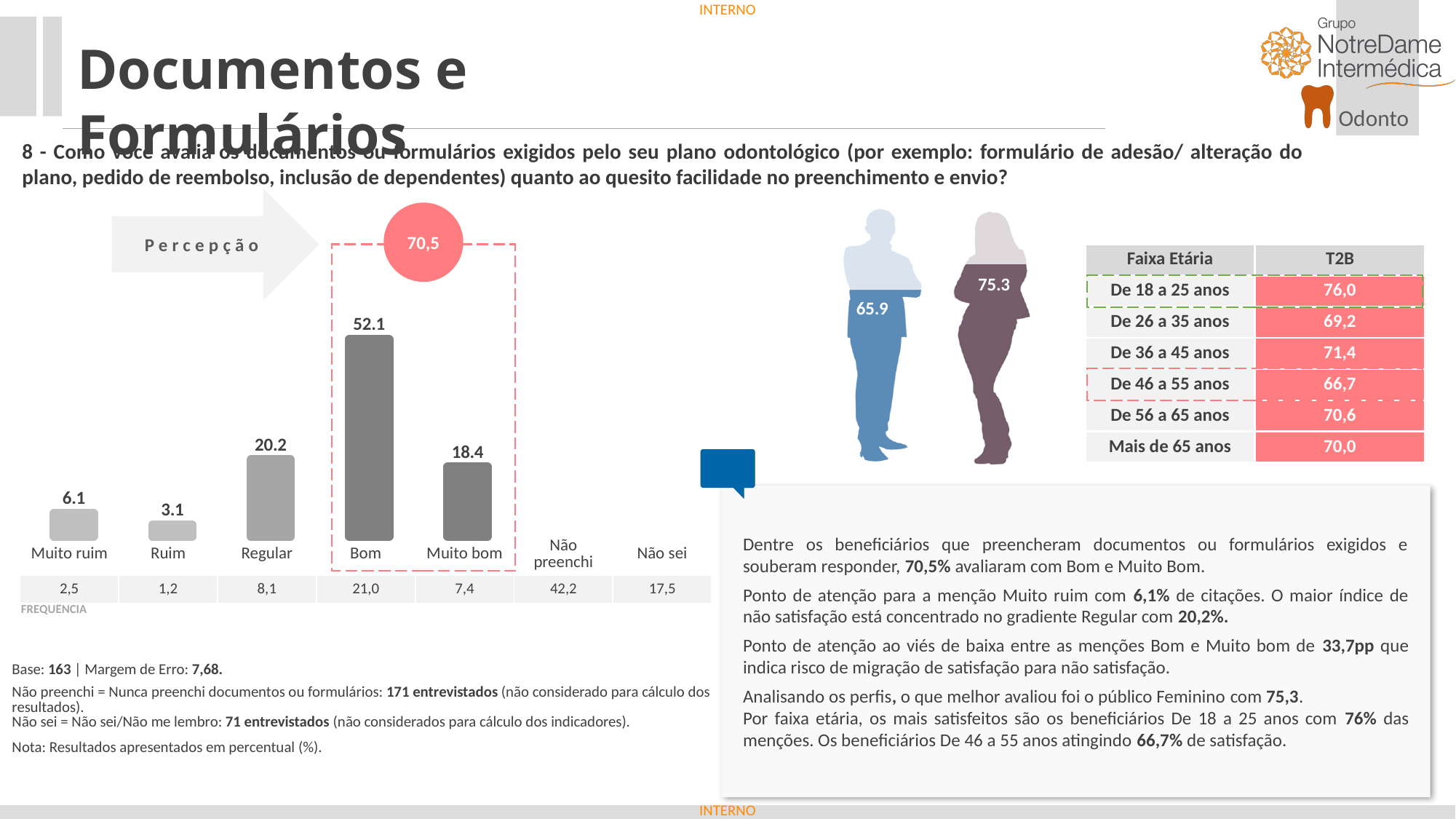
How many bars are plotted in the chart? 5 What type of chart is used to show the evaluation of documents and forms? Bar chart What is the value shown for the 'Bom' bar? 52.1 What is the value shown for the 'Regular' bar? 20.2 What is the value shown for the 'Muito bom' bar? 18.4 What is the value shown for the 'Muito ruim' bar? 6.1 What value is shown in the pink circle above the dashed box around 'Bom' and 'Muito bom'? 70,5 What is the difference between the 'Bom' and 'Muito bom' values? 33.7 Which category has the highest bar in the chart? Bom What is the combined value of the 'Bom' and 'Muito bom' bars? 70.5 Which category has the lowest bar in the chart? Ruim Which is larger, the value for 'Regular' or the value for 'Muito bom'? Regular